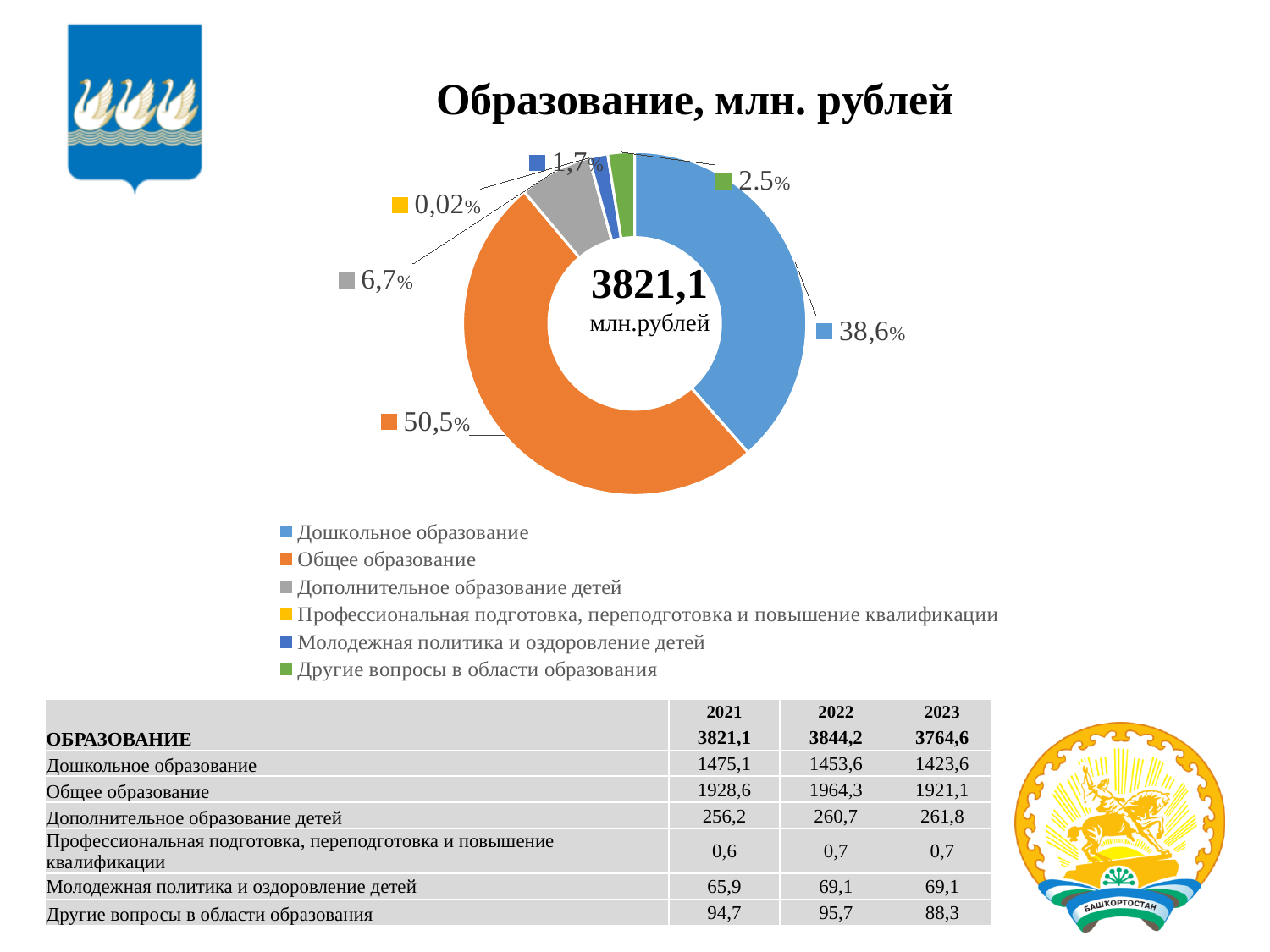
What share of the doughnut chart does Дошкольное образование take? 38,6% What total value is printed in the centre of the doughnut chart? 3821,1 млн.рублей Which slice is larger: Другие вопросы в области образования or Молодежная политика и оздоровление детей? Другие вопросы в области образования How many categories does the legend of the doughnut chart list? 6 What is the title of the chart? Образование, млн. рублей What percentage is shown for Дополнительное образование детей? 6,7% What percentage is shown for Профессиональная подготовка, переподготовка и повышение квалификации? 0,02% What kind of chart is shown on the slide? doughnut chart What percentage is shown for Молодежная политика и оздоровление детей? 1,7% Which category has the largest slice in the doughnut chart? Общее образование Which category has the smallest slice in the doughnut chart? Профессиональная подготовка, переподготовка и повышение квалификации What share of the doughnut chart does Общее образование take? 50,5%